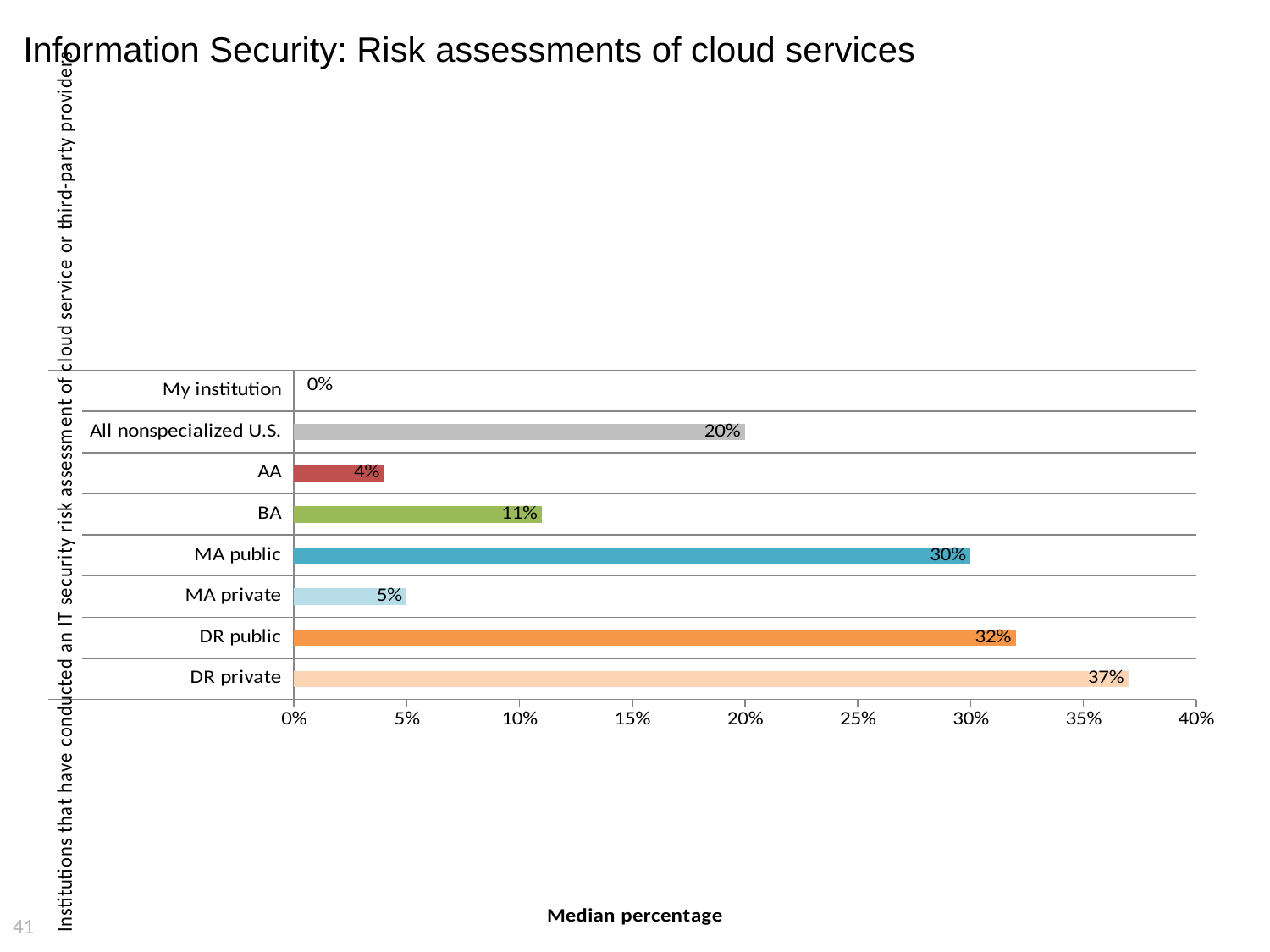
What is the difference between the values for DR private and MA public? 7% Is the value for MA public greater or less than 25%? greater What kind of chart is shown on the slide? Bar chart What is the value shown for My institution? 0% How many categories are shown on the chart? 8 What is the label of the horizontal axis? Median percentage Which is larger, the value for BA or the value for AA? BA Which category has the highest median percentage? DR private Which category has the lowest median percentage? My institution What is the difference between the values for MA private and AA? 1% What is the median percentage for All nonspecialized U.S.? 20% What is the median percentage for DR public? 32%